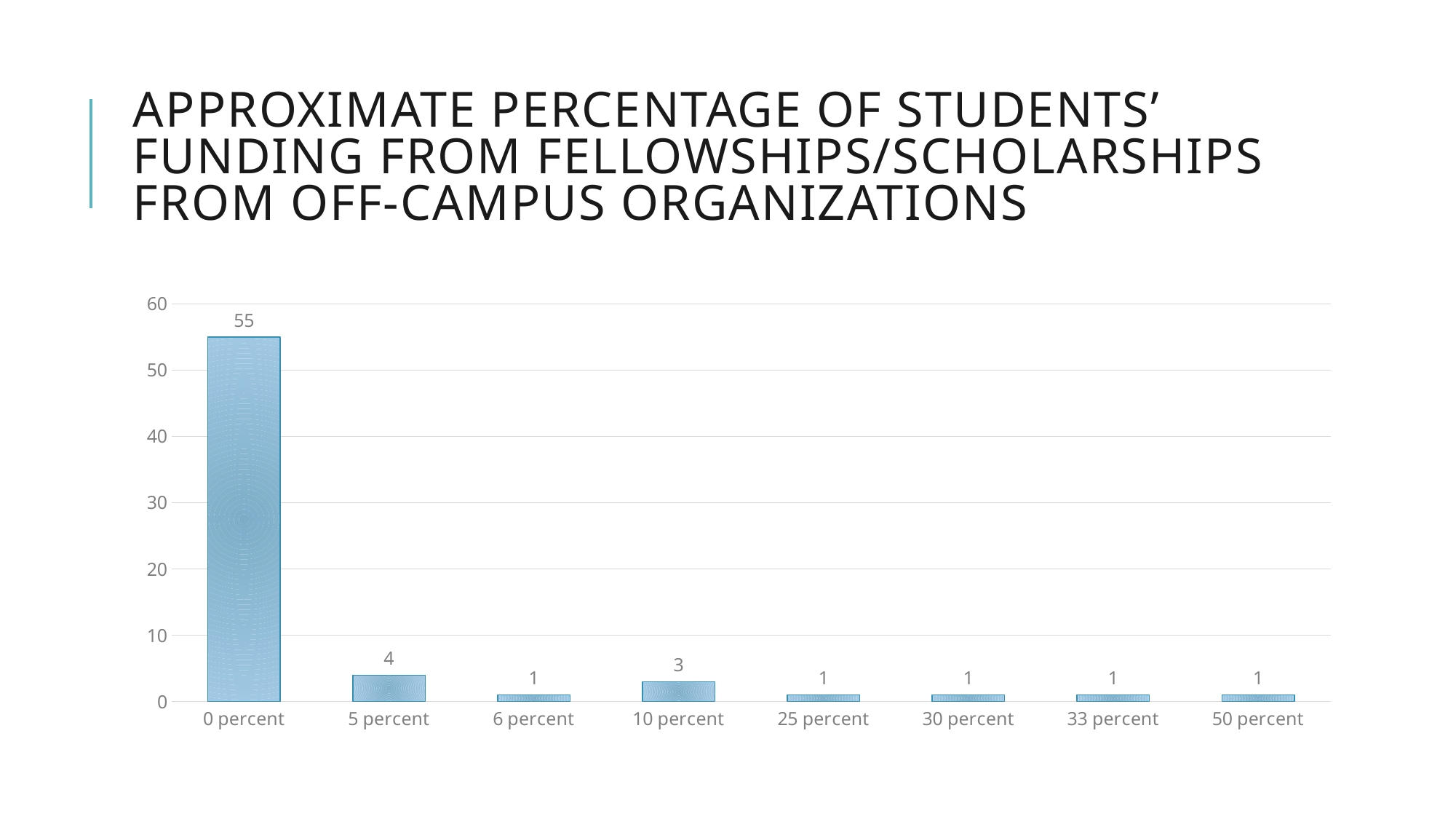
What is the title of the slide? Approximate percentage of students' funding from fellowships/scholarships from off-campus organizations What is the value for the 25 percent category? 1 What is the value for the 10 percent category? 3 Is the value for 0 percent greater or less than 50? greater What is the difference between the values for 0 percent and 5 percent? 51 What kind of chart is shown on the slide? bar chart How many categories are shown on the x axis? 8 What is the value for the 5 percent category? 4 Which category has the highest value? 0 percent What is the value for the 0 percent category? 55 What is the difference between the values for 5 percent and 10 percent? 1 Which is larger, the value for 5 percent or the value for 10 percent? 5 percent